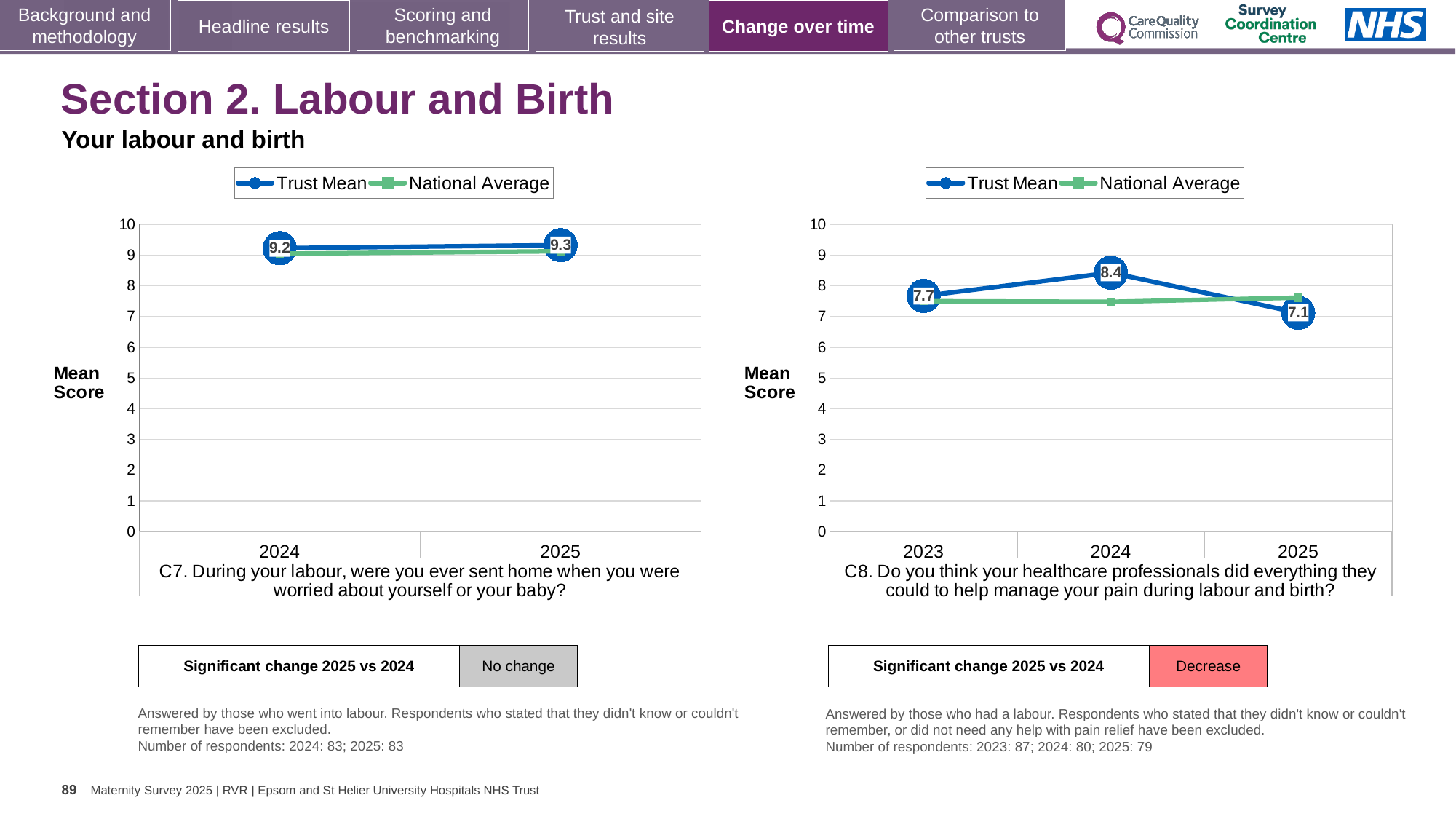
In the left chart (C7), what is the Trust Mean for 2024? 9.2 In the right chart (C8), which year has the lowest Trust Mean? 2025 In the right chart (C8), what is the Trust Mean for 2025? 7.1 In the left chart (C7), is the National Average for 2024 greater or less than 8? greater In the right chart (C8), what is the Trust Mean for 2024? 8.4 In the right chart (C8), what is the difference between the Trust Mean for 2024 and 2025? 1.3 In the right chart (C8), which year has the highest Trust Mean? 2024 How many years are shown on the x axis of the right chart (C8)? 3 In the right chart (C8), is the Trust Mean higher in 2023 or in 2025? 2023 What kind of chart is the right chart (C8)? Line chart How many series does the legend of the left chart (C7) list? 2 In the left chart (C7), what is the Trust Mean for 2025? 9.3